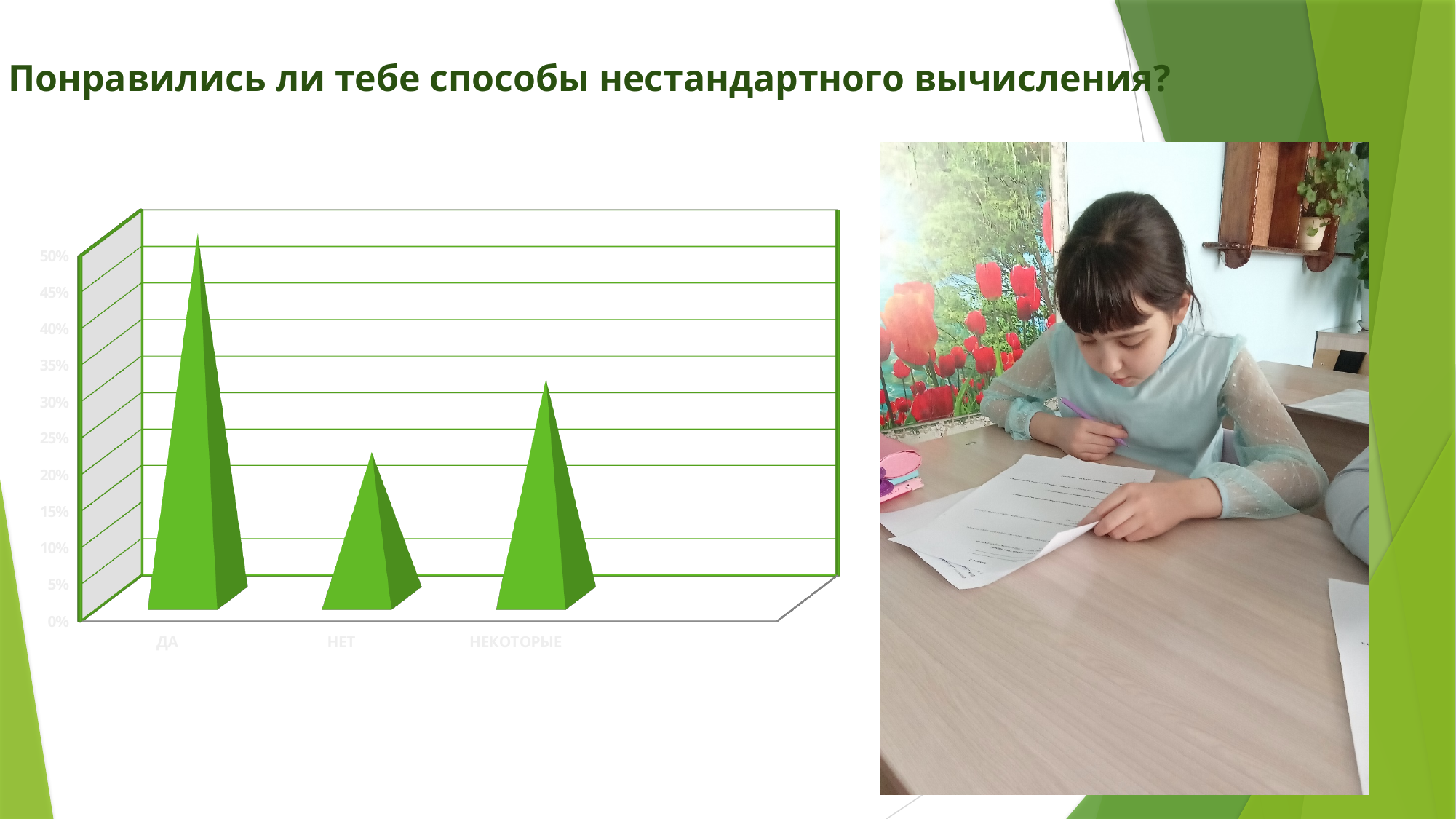
What is the title of the slide above the chart? Понравились ли тебе способы нестандартного вычисления? What colour are the bars in the chart? green Which is larger, the value for ДА or the value for НЕКОТОРЫЕ? ДА Is the value for НЕКОТОРЫЕ greater or less than 40%? less Is the value for НЕТ greater or less than 30%? less What kind of chart is shown on the slide? bar chart Which category has the lowest value in the chart? НЕТ Is the value for ДА greater or less than 40%? greater Which category has the highest value in the chart? ДА Which is larger, the value for НЕТ or the value for НЕКОТОРЫЕ? НЕКОТОРЫЕ How many categories are shown on the x axis of the chart? 3